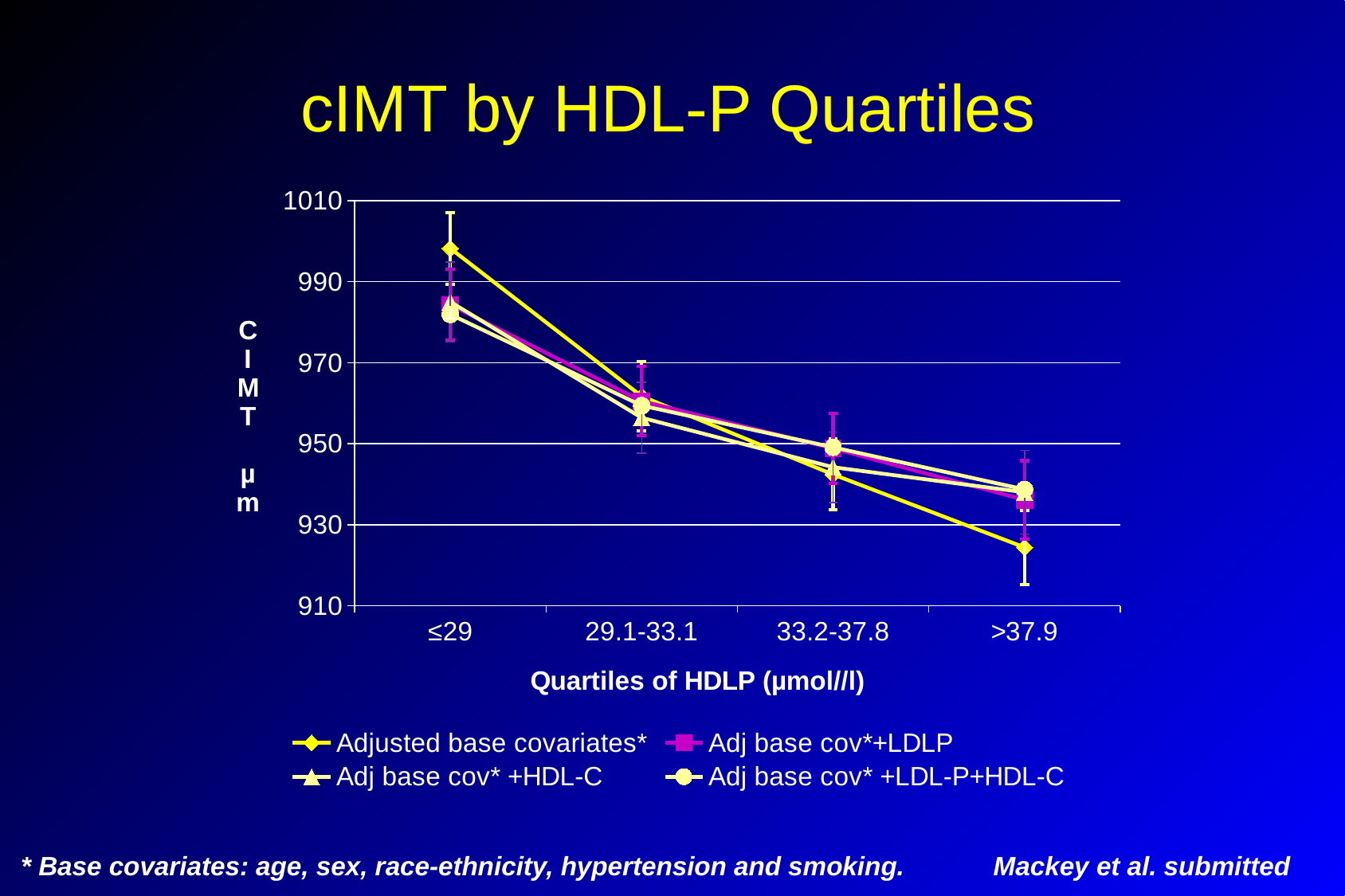
At the >37.9 quartile, which series has the lowest cIMT value? Adjusted base covariates* At the ≤29 quartile, which series has the highest cIMT value? Adjusted base covariates* Is the value for Adj base cov* +LDL-P+HDL-C at the >37.9 quartile greater or less than 930? greater How many series does the legend list? 4 For the Adjusted base covariates* series, which quartile has the lowest cIMT value? >37.9 How many HDL-P quartile categories are shown on the x axis? 4 What is the title of the chart? cIMT by HDL-P Quartiles Is the value for Adjusted base covariates* at the ≤29 quartile greater or less than 990? greater What kind of chart is shown on the slide? line chart For the Adjusted base covariates* series, which quartile has the highest cIMT value? ≤29 Is the value for Adjusted base covariates* at the >37.9 quartile greater or less than 930? less Do the cIMT values rise or fall as the HDL-P quartiles increase along the x axis? fall